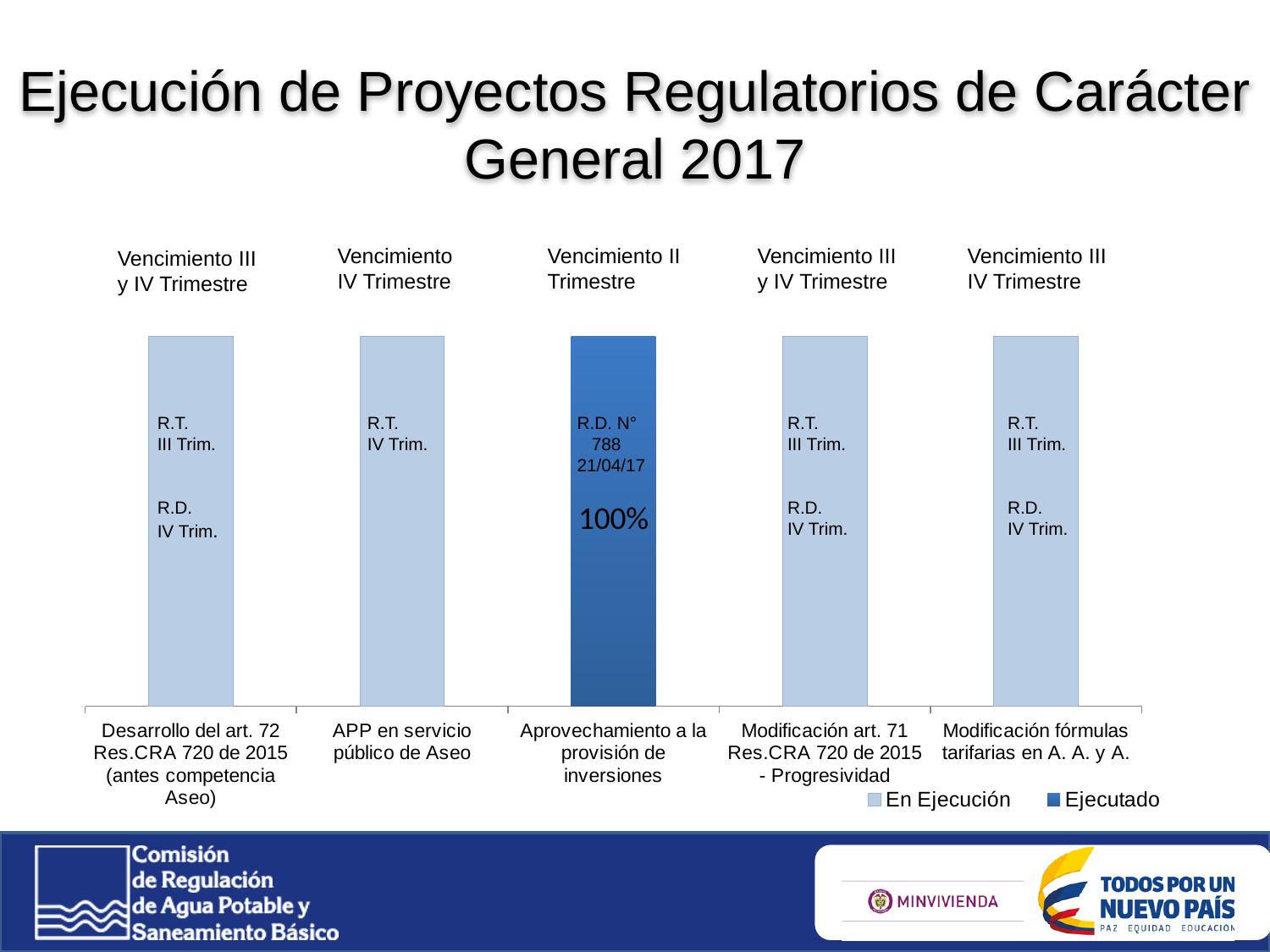
How many categories (projects) are shown along the x axis of the chart? 5 How many series does the chart legend list? 2 What is the 'Vencimiento' label shown above the bar for 'APP en servicio público de Aseo'? Vencimiento IV Trimestre How many of the five projects are shown in the 'En Ejecución' series? 4 What percentage value is printed on the bar for 'Aprovechamiento a la provisión de inversiones'? 100% What are the two series named in the chart legend? En Ejecución and Ejecutado What resolution number and date are printed on the bar for 'Aprovechamiento a la provisión de inversiones'? R.D. N° 788, 21/04/17 What is the 'Vencimiento' label shown above the bar for 'Modificación art. 71 Res.CRA 720 de 2015 - Progresividad'? Vencimiento III y IV Trimestre Which project is the only one shown in the 'Ejecutado' series (dark blue bar)? Aprovechamiento a la provisión de inversiones What is the 'Vencimiento' label shown above the bar for 'Aprovechamiento a la provisión de inversiones'? Vencimiento II Trimestre What kind of chart is shown on the slide? bar chart What is the label of the first category on the x axis of the chart? Desarrollo del art. 72 Res.CRA 720 de 2015 (antes competencia Aseo)